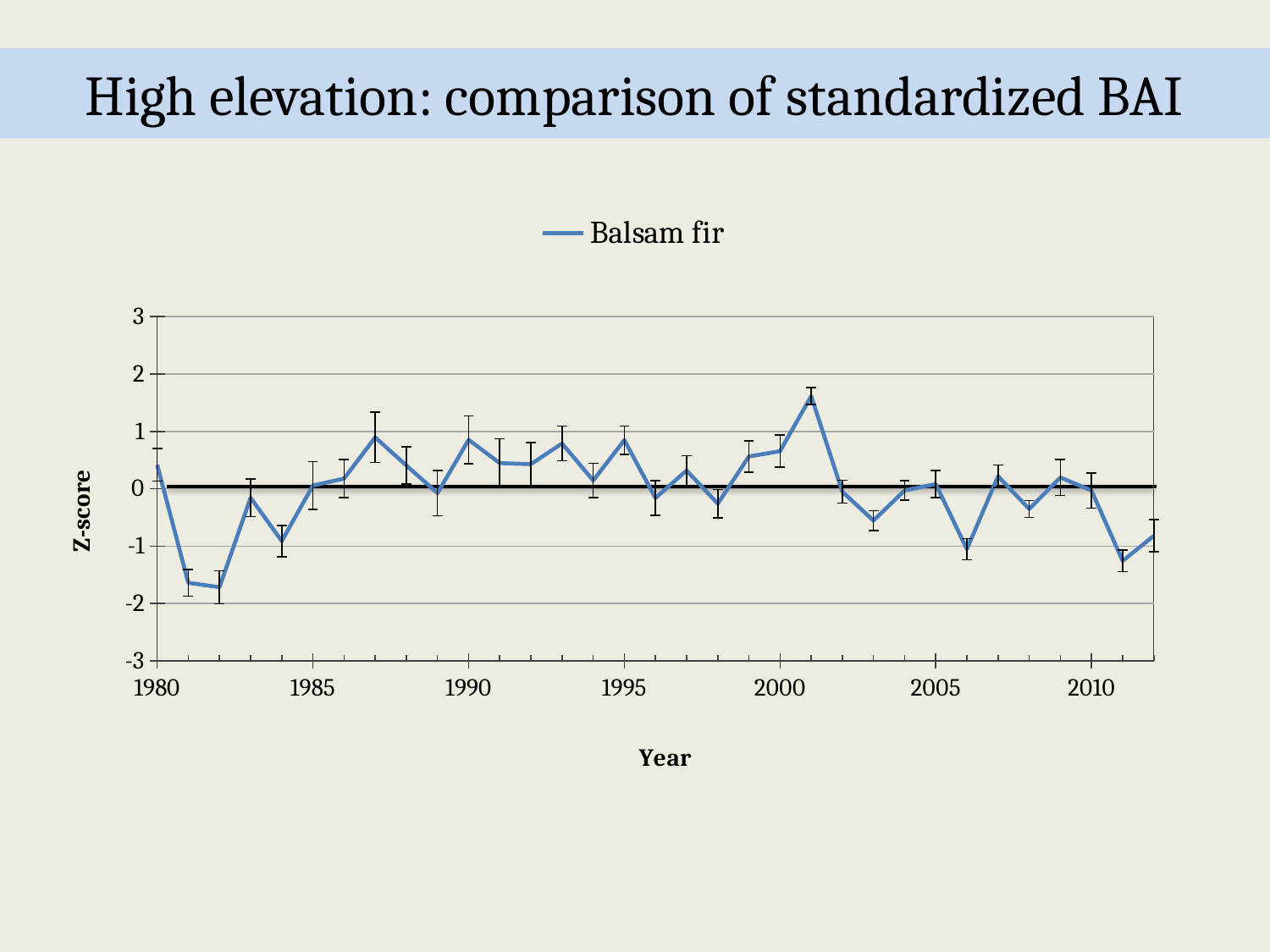
In which year does the Balsam fir Z-score reach its highest value? 2001 Which year has the larger Z-score, 2001 or 1987? 2001 Is the Z-score for 2006 greater or less than 0? less Which year has the larger Z-score, 1981 or 1984? 1984 What kind of chart is shown on the slide? line chart Does the Z-score rise or fall between 1980 and 1982? fall How many series does the legend list? 1 Is the Z-score for 1981 greater or less than -1? less What is the name of the series shown in the legend? Balsam fir Is the Z-score for 2001 greater or less than 1? greater What is the label on the vertical axis? Z-score